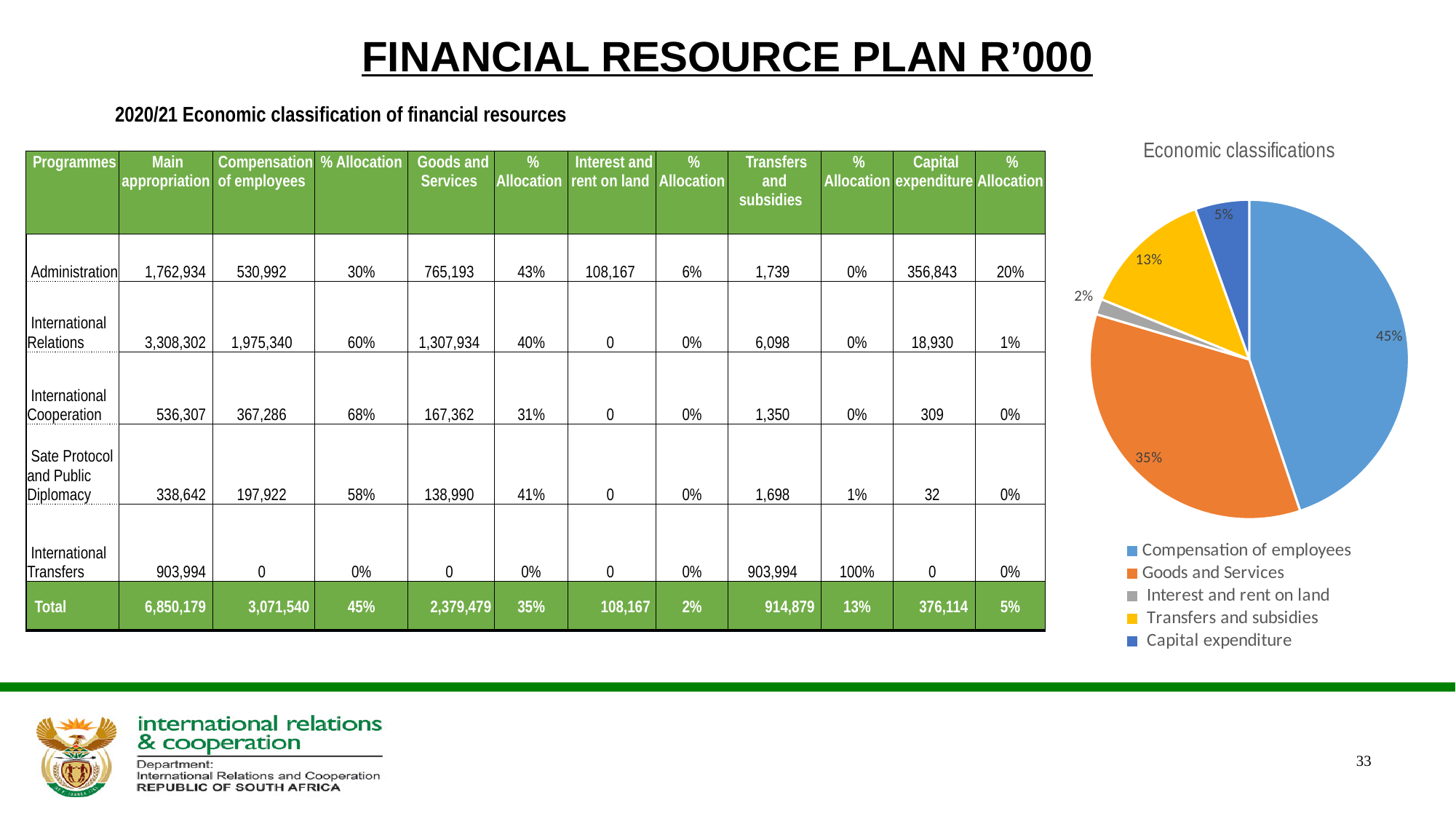
What share of the pie does Interest and rent on land represent? 2% What share of the pie does Compensation of employees represent? 45% What share of the pie does Transfers and subsidies represent? 13% What type of chart is shown on the slide? Pie chart What is the difference in percentage points between Compensation of employees and Goods and Services? 10 Which is larger, Transfers and subsidies or Capital expenditure? Transfers and subsidies Which category has the largest slice of the pie? Compensation of employees What is the title of the chart? Economic classifications How many slices does the pie chart have? 5 Which category has the smallest slice of the pie? Interest and rent on land